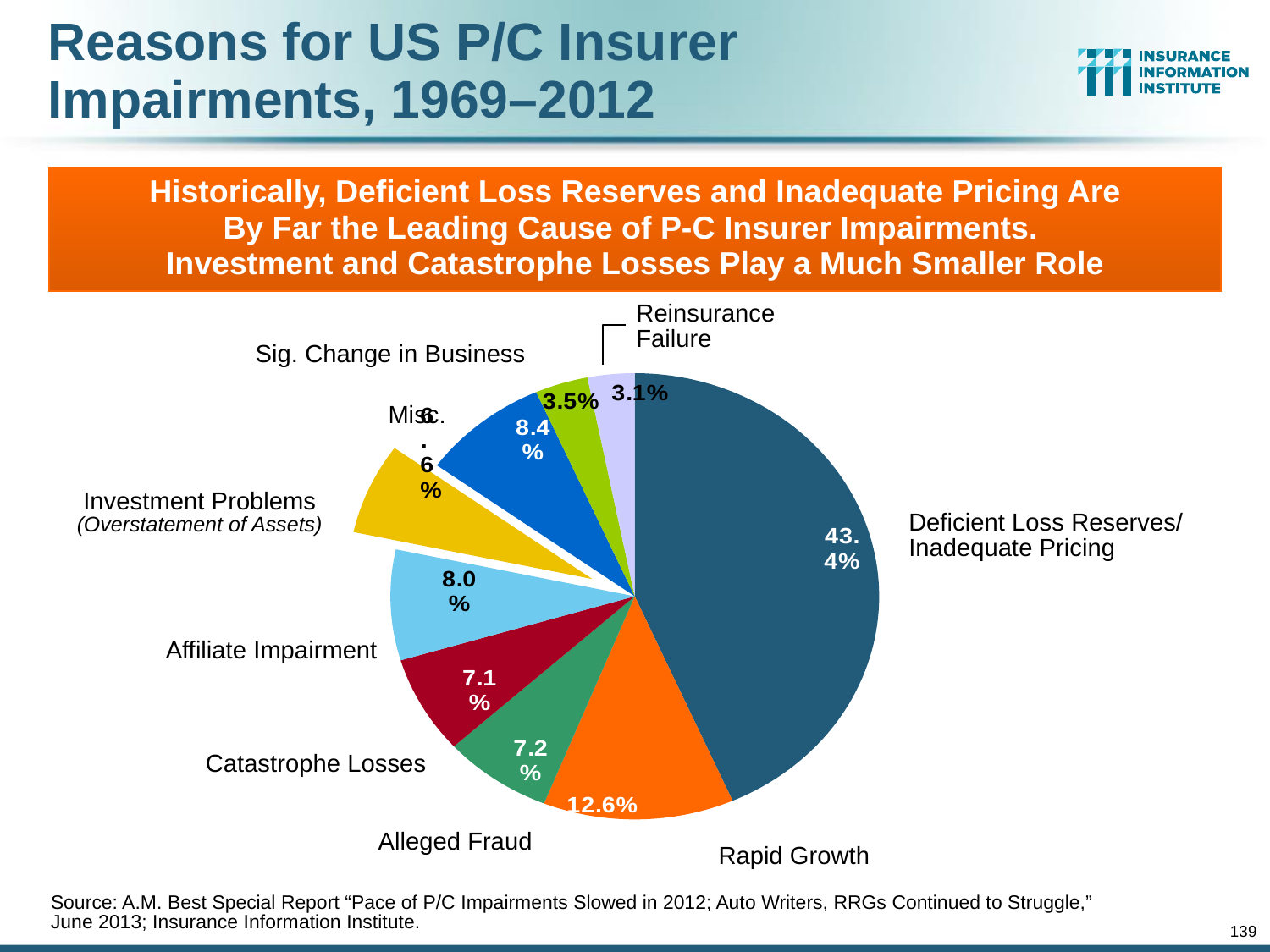
What percentage is shown for Reinsurance Failure? 3.1% Which reason accounts for the largest share of impairments? Deficient Loss Reserves/Inadequate Pricing Which reason accounts for the smallest share of impairments? Reinsurance Failure What is the value shown for Catastrophe Losses? 7.1% Which is larger, the share for Rapid Growth or the share for Affiliate Impairment? Rapid Growth How many slices does the pie chart have? 9 What share of US P/C insurer impairments is attributed to Deficient Loss Reserves/Inadequate Pricing? 43.4% What kind of chart is shown on the slide? Pie chart What is the value shown for Affiliate Impairment? 8.0% What percentage is shown for Sig. Change in Business? 3.5% How many percentage points larger is the Deficient Loss Reserves/Inadequate Pricing share than the Rapid Growth share? 30.8 percentage points What percentage of impairments is attributed to Rapid Growth? 12.6%